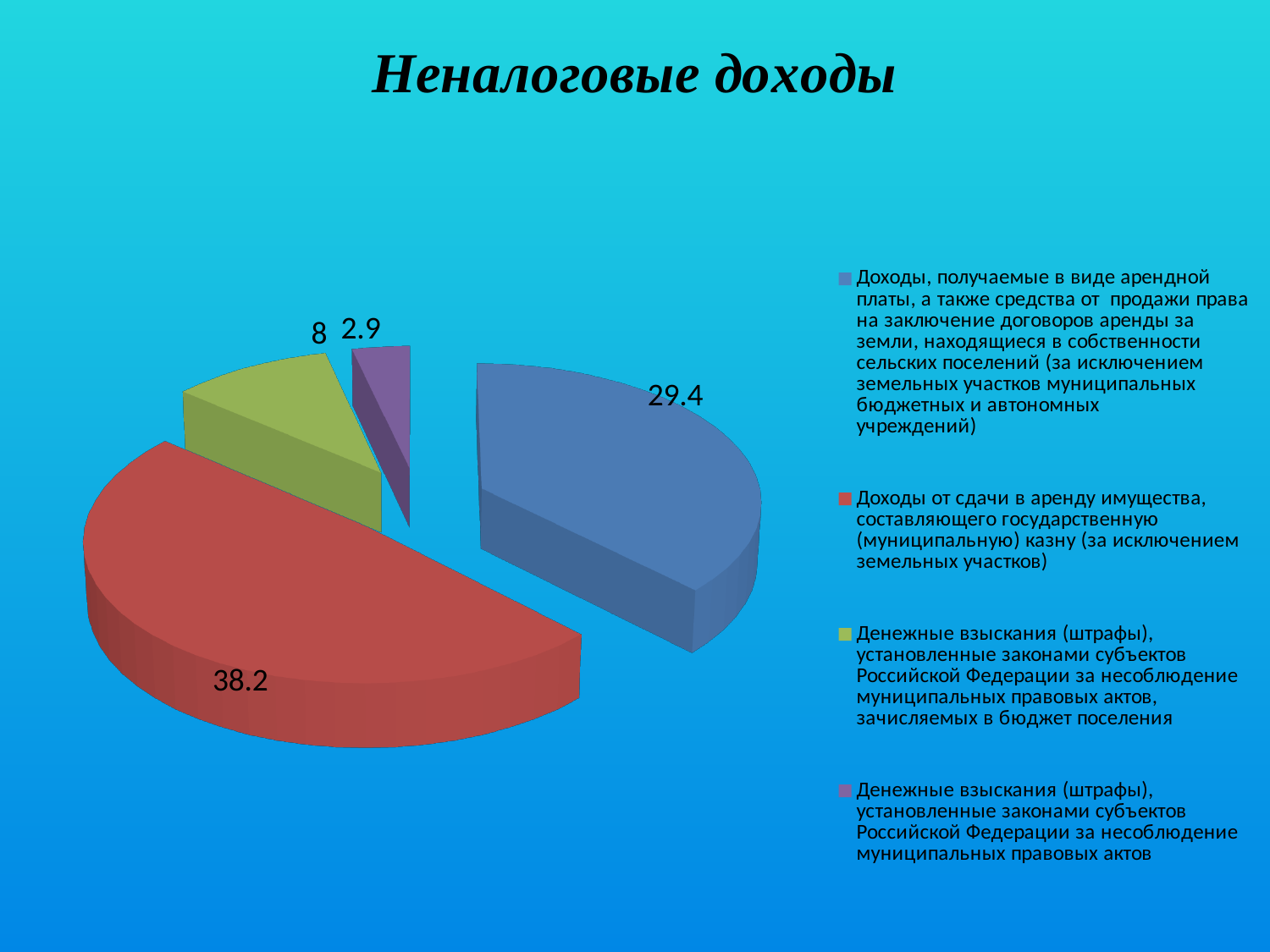
What is the title of the chart on the slide? Неналоговые доходы What is the value of the green slice (штрафы, зачисляемые в бюджет поселения)? 8 How many slices does the pie chart have? 4 How many entries does the legend list? 4 Which is larger: the green slice or the purple slice? The green slice (8) What is the value of the purple slice, the last legend entry? 2.9 Which category has the largest slice in the pie chart? Доходы от сдачи в аренду имущества, составляющего государственную (муниципальную) казну (за исключением земельных участков) What is the difference between the red slice (38.2) and the blue slice (29.4)? 8.8 What is the value of the slice for 'Доходы от сдачи в аренду имущества, составляющего государственную (муниципальную) казну (за исключением земельных участков)'? 38.2 What is the value of the slice for 'Доходы, получаемые в виде арендной платы, а также средства от продажи права на заключение договоров аренды за земли, находящиеся в собственности сельских поселений'? 29.4 What is the smallest value shown on the pie chart? 2.9 What kind of chart is shown on the slide? Pie chart